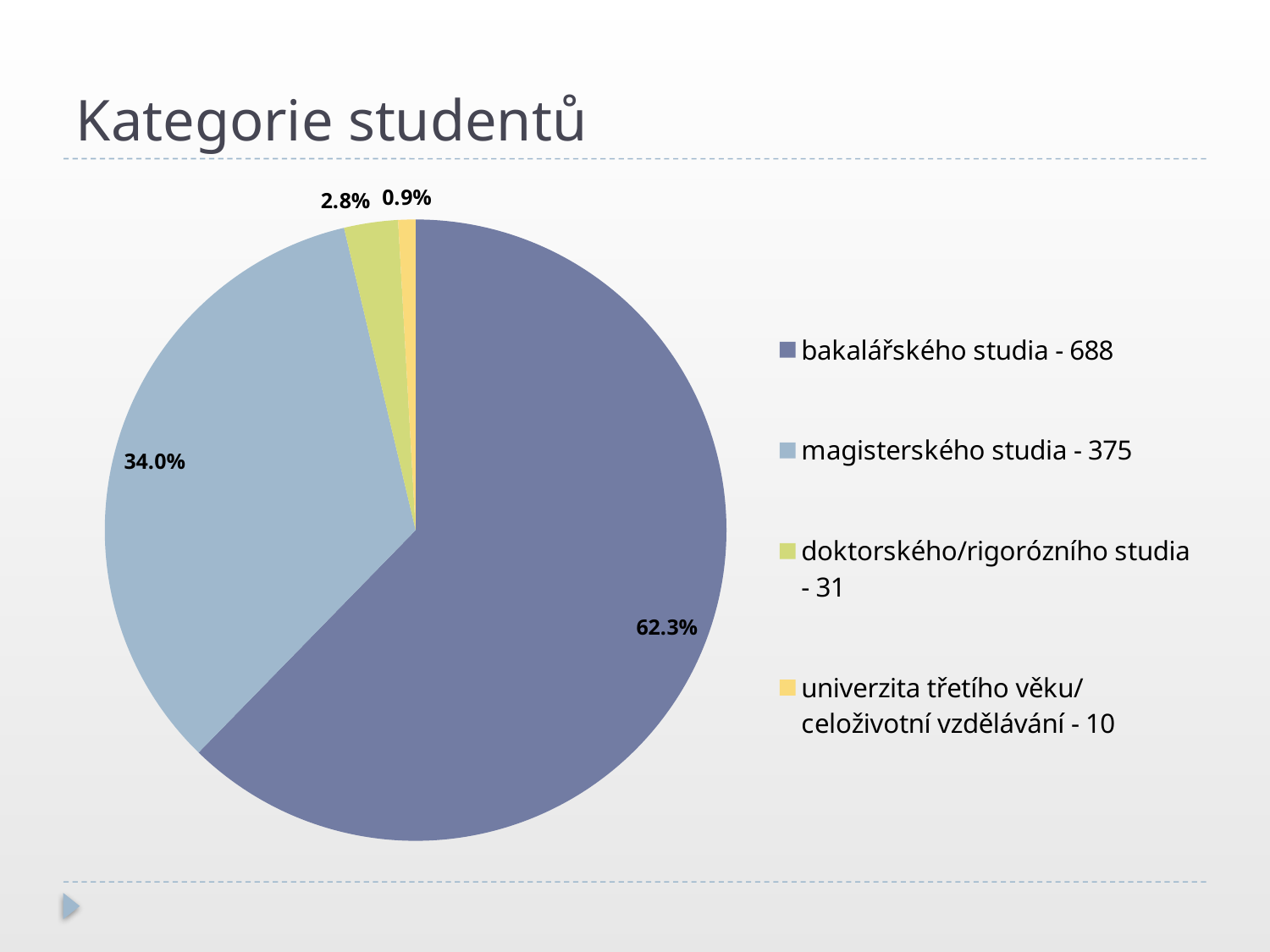
What kind of chart is shown on the slide? pie chart What share of the pie does "doktorského/rigorózního studia" have? 2.8% How many categories does the pie chart show? 4 What share of the pie does "bakalářského studia" have? 62.3% What number is shown in the legend next to "magisterského studia"? 375 Which slice is larger: "doktorského/rigorózního studia" or "univerzita třetího věku/ celoživotní vzdělávání"? doktorského/rigorózního studia Which category has the smallest slice of the pie? univerzita třetího věku/ celoživotní vzdělávání What share of the pie does "magisterského studia" have? 34.0% Which category has the largest slice of the pie? bakalářského studia What is the difference in percentage points between the "bakalářského studia" slice and the "magisterského studia" slice? 28.3 What is the title of the slide containing the pie chart? Kategorie studentů